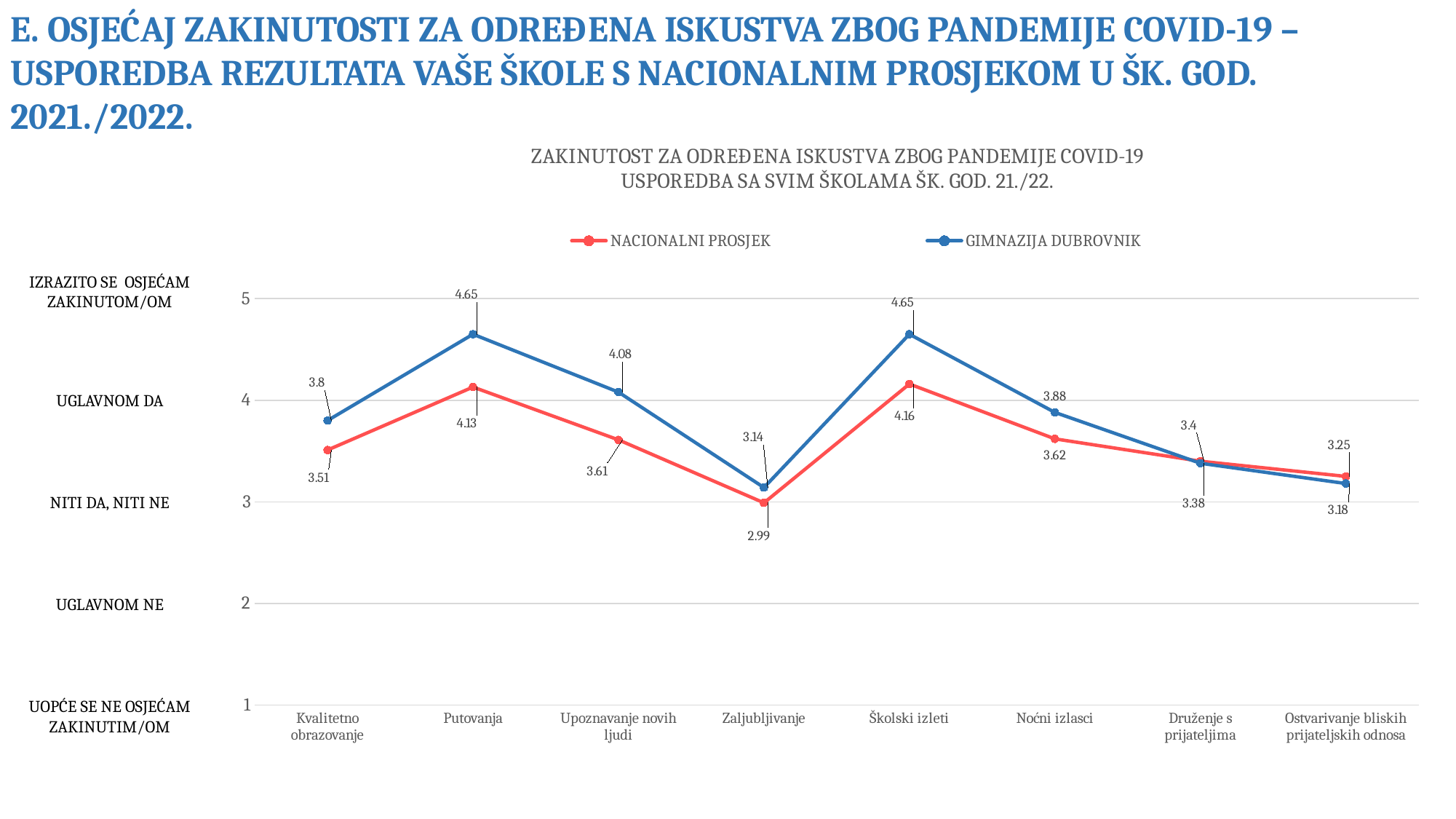
What is the value for GIMNAZIJA DUBROVNIK for Noćni izlasci? 3.88 Which series is drawn in red? NACIONALNI PROSJEK How many series does the legend list? 2 Which category has the lowest value for GIMNAZIJA DUBROVNIK? Zaljubljivanje For Upoznavanje novih ljudi, which series has the larger value, NACIONALNI PROSJEK or GIMNAZIJA DUBROVNIK? GIMNAZIJA DUBROVNIK What type of chart is shown on the slide? Line chart What is the difference between GIMNAZIJA DUBROVNIK and NACIONALNI PROSJEK for Putovanja? 0.52 What is the value for NACIONALNI PROSJEK for Zaljubljivanje? 2.99 Is the value for NACIONALNI PROSJEK for Školski izleti greater or less than 4? greater What is the value for GIMNAZIJA DUBROVNIK for Putovanja? 4.65 How many categories are shown on the x axis? 8 Which category has the highest value for NACIONALNI PROSJEK? Školski izleti